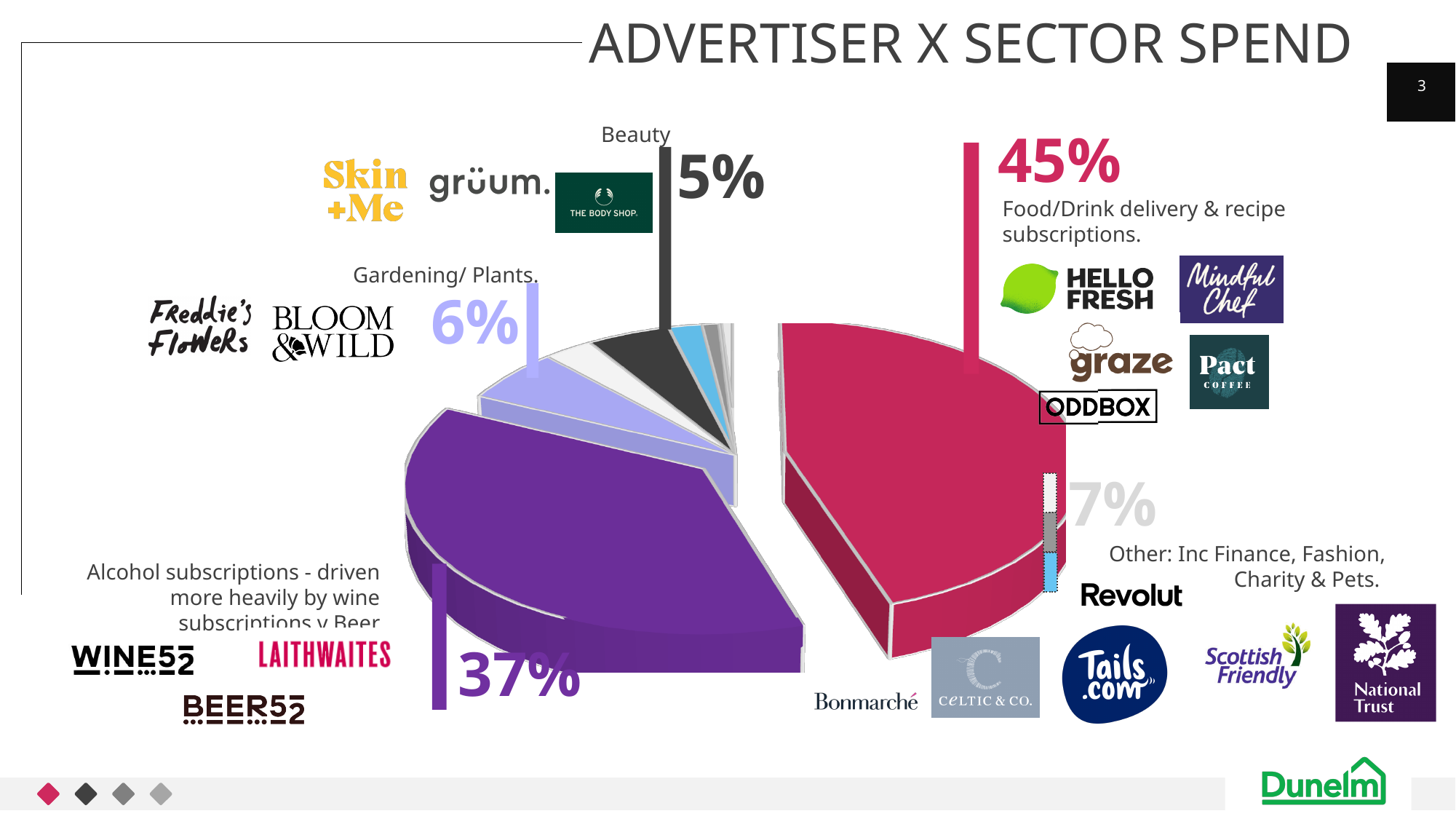
What share of spend is attributed to Beauty? 5% What is the difference in share between Food/Drink delivery & recipe subscriptions and Alcohol subscriptions? 8% Which labelled sector has the smallest share of spend? Beauty How many sectors are labelled with a percentage on the chart? 5 What share of spend is attributed to Gardening/ Plants? 6% What share of spend is attributed to the Other sector (Inc Finance, Fashion, Charity & Pets)? 7% What kind of chart is shown on the slide? pie chart Which sector has the largest share of spend? Food/Drink delivery & recipe subscriptions What share of spend is attributed to Alcohol subscriptions? 37% Which has a larger share of spend, Gardening/ Plants or Beauty? Gardening/ Plants What is the title of the slide? ADVERTISER X SECTOR SPEND What share of spend is attributed to Food/Drink delivery & recipe subscriptions? 45%